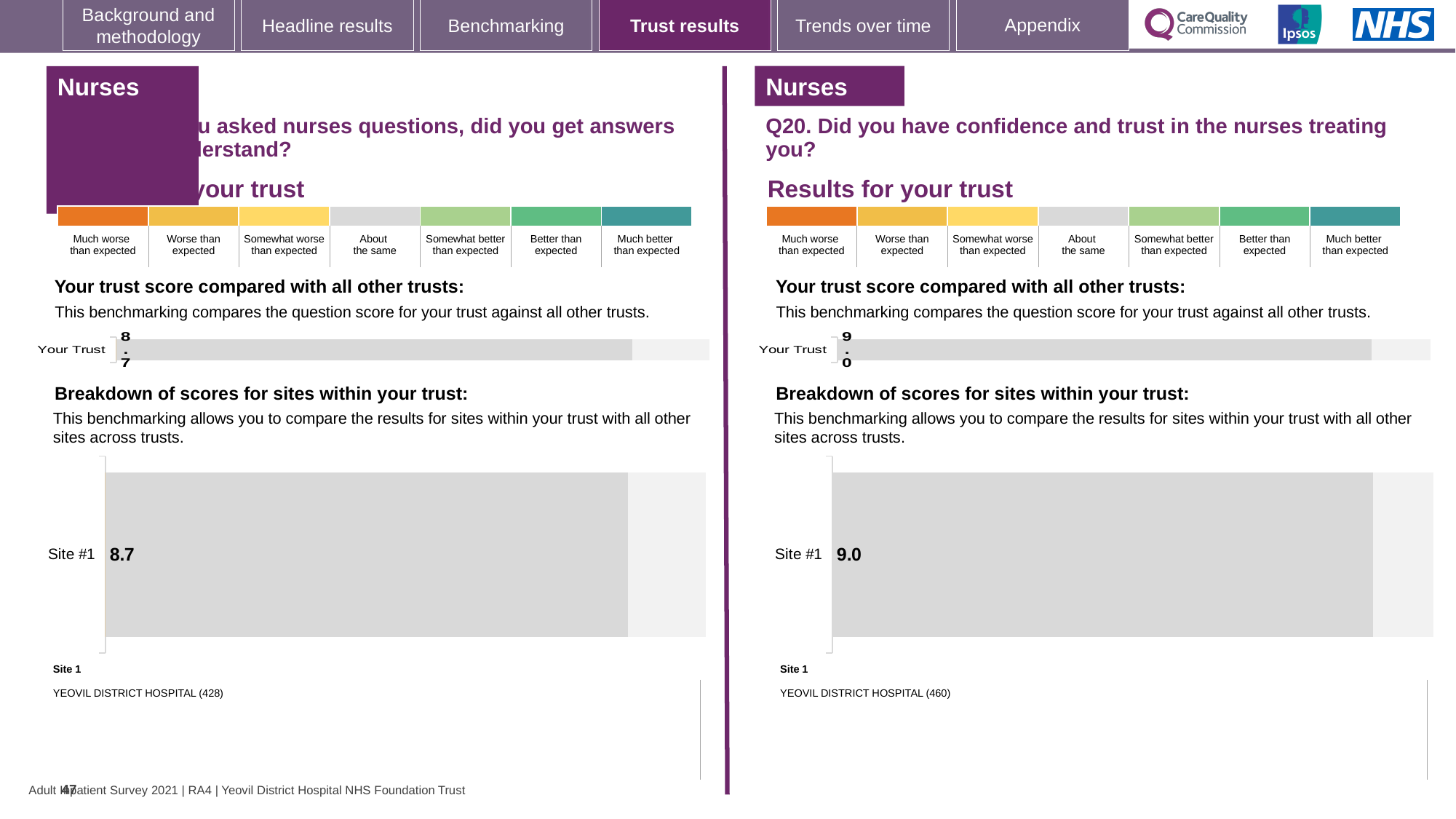
On the left-hand 'Breakdown of scores for sites within your trust' chart, what is the score for Site #1? 8.7 How many bars are plotted on the left-hand 'Your trust score compared with all other trusts' chart? 1 On the right-hand Q20 'Breakdown of scores for sites within your trust' chart, what is the score for Site #1? 9.0 What is the difference between the Site #1 score on the right-hand Q20 breakdown chart and the Site #1 score on the left-hand breakdown chart? 0.3 What kind of chart is used to show the Site #1 score on the right-hand Q20 breakdown chart? Bar chart Is the Your Trust score on the right-hand Q20 chart greater or less than the Your Trust score on the left-hand chart? greater On the right-hand Q20 breakdown chart, which hospital is listed as Site 1? YEOVIL DISTRICT HOSPITAL Which Site #1 score is larger: the one on the left-hand breakdown chart or the one on the right-hand Q20 breakdown chart? The right-hand Q20 chart (9.0) What is the label of the single bar on the left-hand 'Your trust score compared with all other trusts' chart? Your Trust On the left-hand 'Your trust score compared with all other trusts' chart, what is the score shown for Your Trust? 8.7 On the right-hand chart for Q20 (confidence and trust in the nurses treating you), what is the score shown for Your Trust? 9.0 How many sites are shown on the right-hand Q20 'Breakdown of scores for sites within your trust' chart? 1